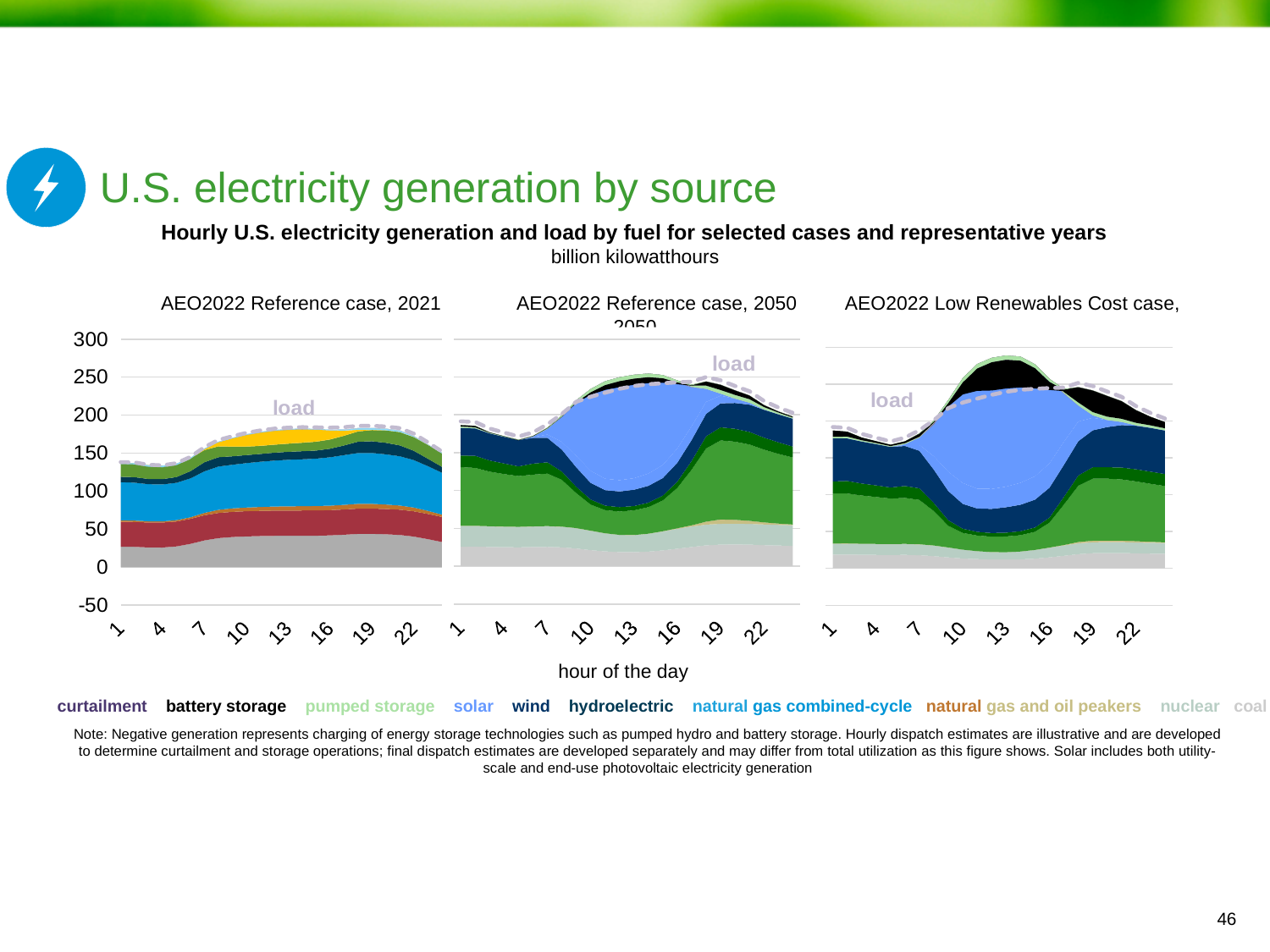
In the AEO2022 Reference case, 2050 chart, is the load at hour 13 greater or less than 200? greater How many chart panels are shown on the slide? 3 In the AEO2022 Reference case, 2021 chart, is the total generation at hour 4 greater or less than 200? less What unit is shown for the y axis of the charts? billion kilowatthours What is the label of the shared x axis beneath the three charts? hour of the day How many fuel/source series does the legend below the charts list? 10 In the AEO2022 Reference case, 2021 chart, is the load at hour 13 greater or less than 150? greater What kind of chart is used in each of the three panels on this slide? Stacked area chart Which chart shows the higher peak total generation: the AEO2022 Reference case, 2050 chart or the AEO2022 Low Renewables Cost case, 2050 chart? AEO2022 Low Renewables Cost case, 2050 In the AEO2022 Reference case, 2021 chart, does the load rise or fall from hour 1 to hour 13? rises